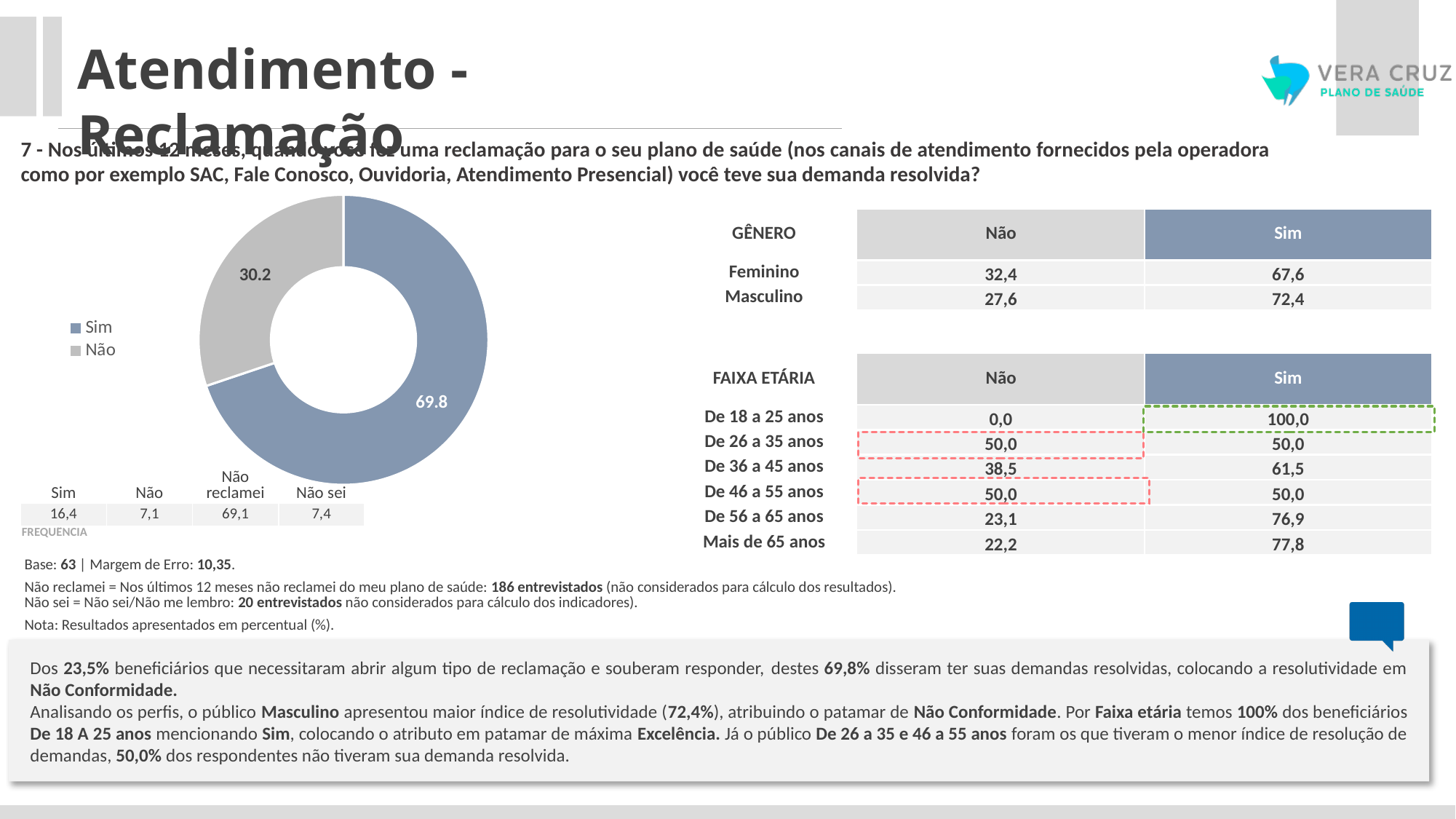
Which category has the largest slice in the donut chart? Sim What type of chart is shown on the left of the slide? Pie chart (donut) In the donut chart, what is the difference between the values for Sim and Não? 39.6 In the donut chart, what is the value for Não? 30.2 How many slices does the donut chart have? 2 In the donut chart, what is the value for Sim? 69.8 Which category has the smallest slice in the donut chart? Não In the donut chart, which is larger: Sim or Não? Sim In the donut chart legend, which colour represents Sim? Blue In the donut chart legend, which colour represents Não? Grey How many entries does the legend of the donut chart list? 2 What share of the donut chart does the Sim slice represent? 69.8